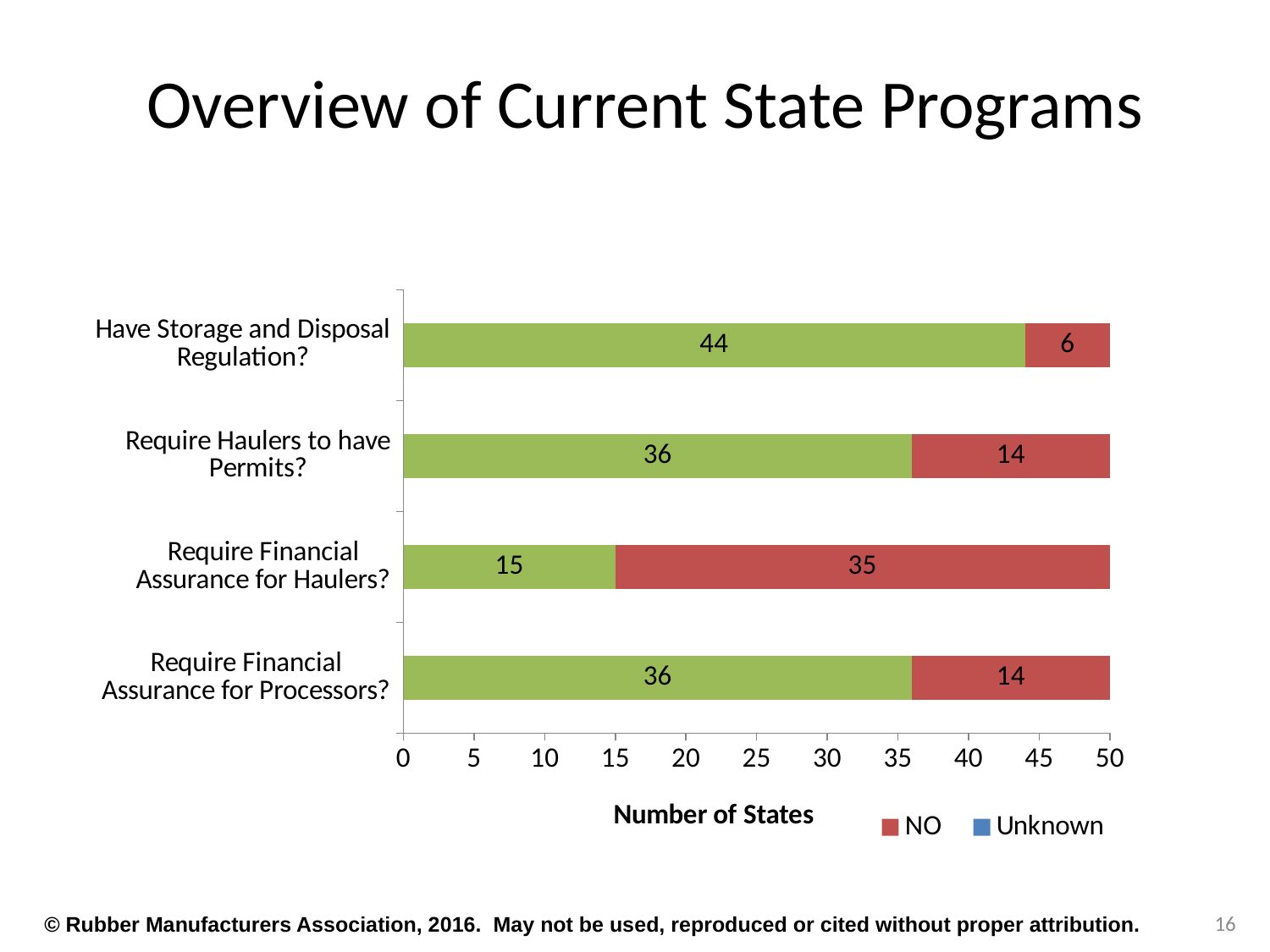
What is the NO value for "Require Financial Assurance for Haulers?"? 35 How many categories are shown on the chart? 4 Which category has the highest NO value? Require Financial Assurance for Haulers? What is the total of the stacked bar for "Require Financial Assurance for Processors?"? 50 What is the NO value for "Have Storage and Disposal Regulation?"? 6 What kind of chart is shown on the slide? Stacked bar chart What is the value of the green segment for "Require Haulers to have Permits?"? 36 What is the title of the horizontal axis? Number of States How many series does the legend list? 2 Which has the larger green segment: "Have Storage and Disposal Regulation?" or "Require Haulers to have Permits?"? Have Storage and Disposal Regulation? Which category has the lowest NO value? Have Storage and Disposal Regulation? What is the difference between the NO value for "Require Financial Assurance for Haulers?" and the NO value for "Have Storage and Disposal Regulation?"? 29